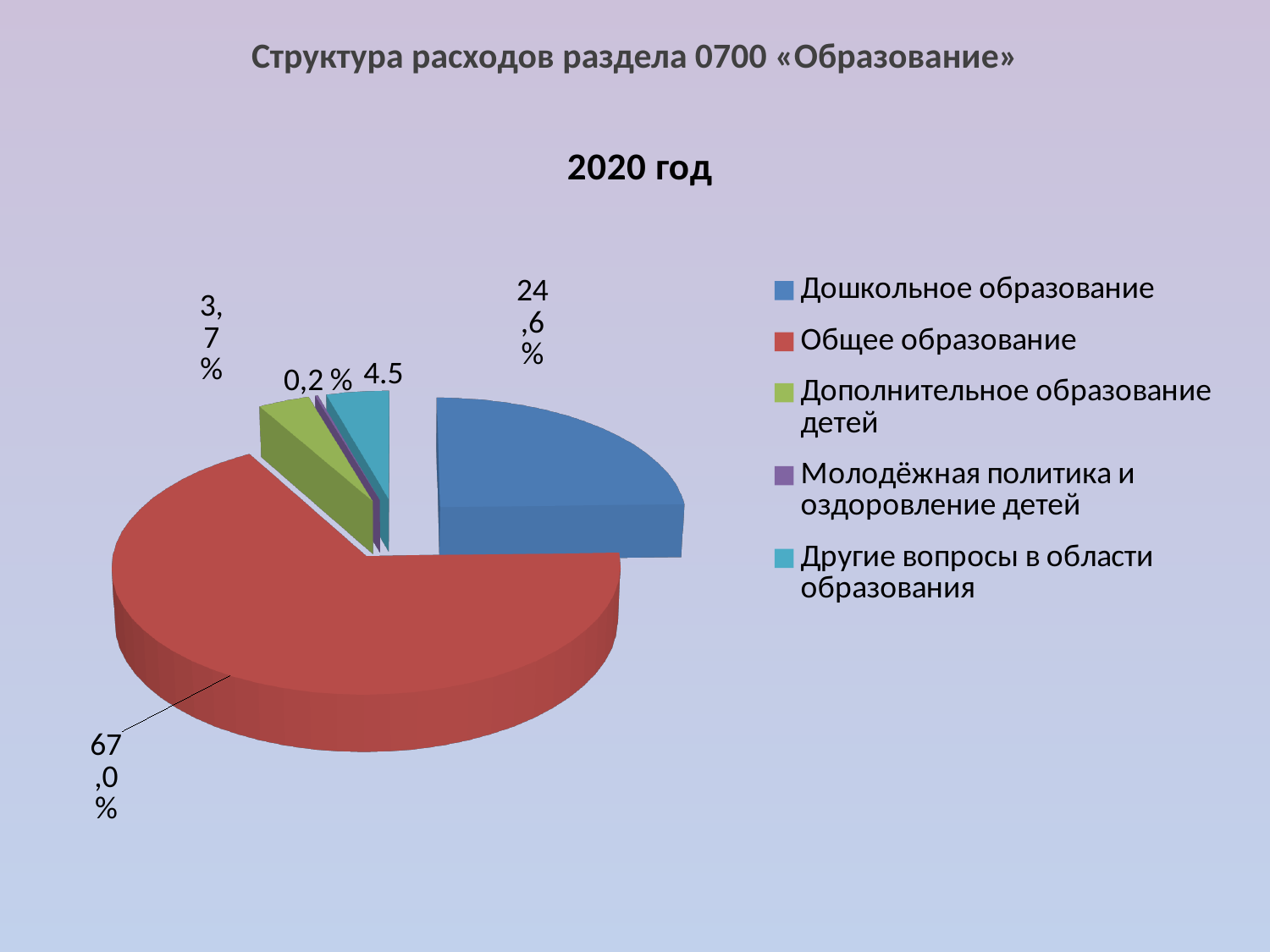
What is the chart's title? 2020 год What share of expenditure is labelled for Дошкольное образование? 24,6% Which category has the largest slice of the pie? Общее образование What share of expenditure is labelled for Общее образование? 67,0% What share is labelled for Молодёжная политика и оздоровление детей? 0,2% What share is labelled for Дополнительное образование детей? 3,7% What colour is the slice for Общее образование? red How many categories does the legend list? 5 Which category has the smallest slice of the pie? Молодёжная политика и оздоровление детей Which is larger, the share for Дошкольное образование or the share for Дополнительное образование детей? Дошкольное образование What kind of chart is shown on the slide? pie chart What value is labelled for Другие вопросы в области образования? 4.5